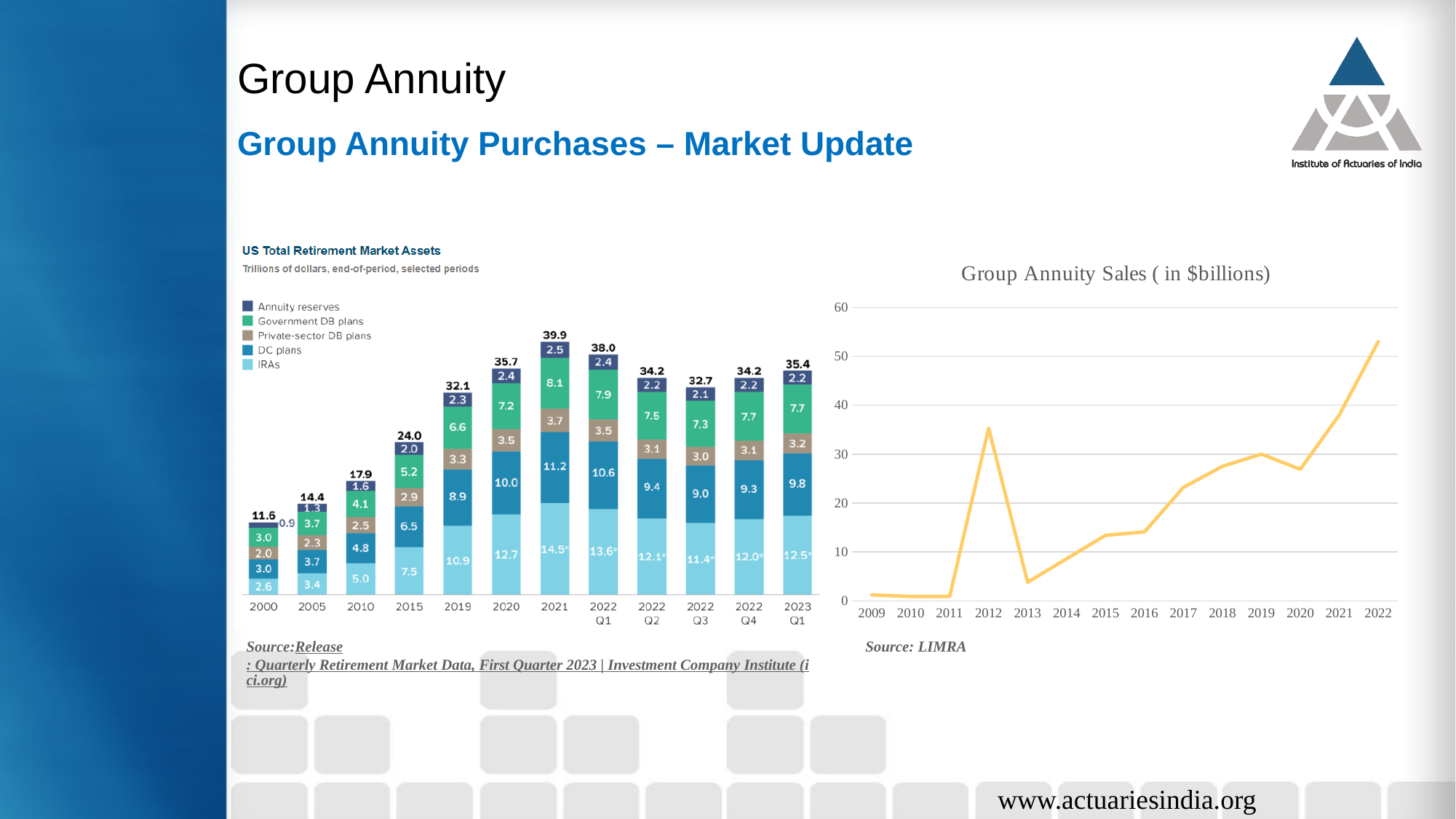
On the US Total Retirement Market Assets chart, what is the value of DC plans in 2020? 10.0 On the US Total Retirement Market Assets chart, what is the difference between the totals for 2021 and 2022 Q1? 1.9 On the US Total Retirement Market Assets chart, how many series does the legend list? 5 On the US Total Retirement Market Assets chart, which period has the lowest total? 2000 On the Group Annuity Sales chart, is the value for 2022 greater or less than 50? greater What kind of chart is the Group Annuity Sales chart? Line chart On the Group Annuity Sales chart, is the value for 2013 greater or less than 10? less On the Group Annuity Sales chart, which year has the highest value? 2022 On the US Total Retirement Market Assets chart, how many periods are shown on the x axis? 12 On the US Total Retirement Market Assets chart, what is the value of Government DB plans in 2023 Q1? 7.7 On the US Total Retirement Market Assets chart, which period has the highest total? 2021 On the US Total Retirement Market Assets chart, what is the total for 2021? 39.9